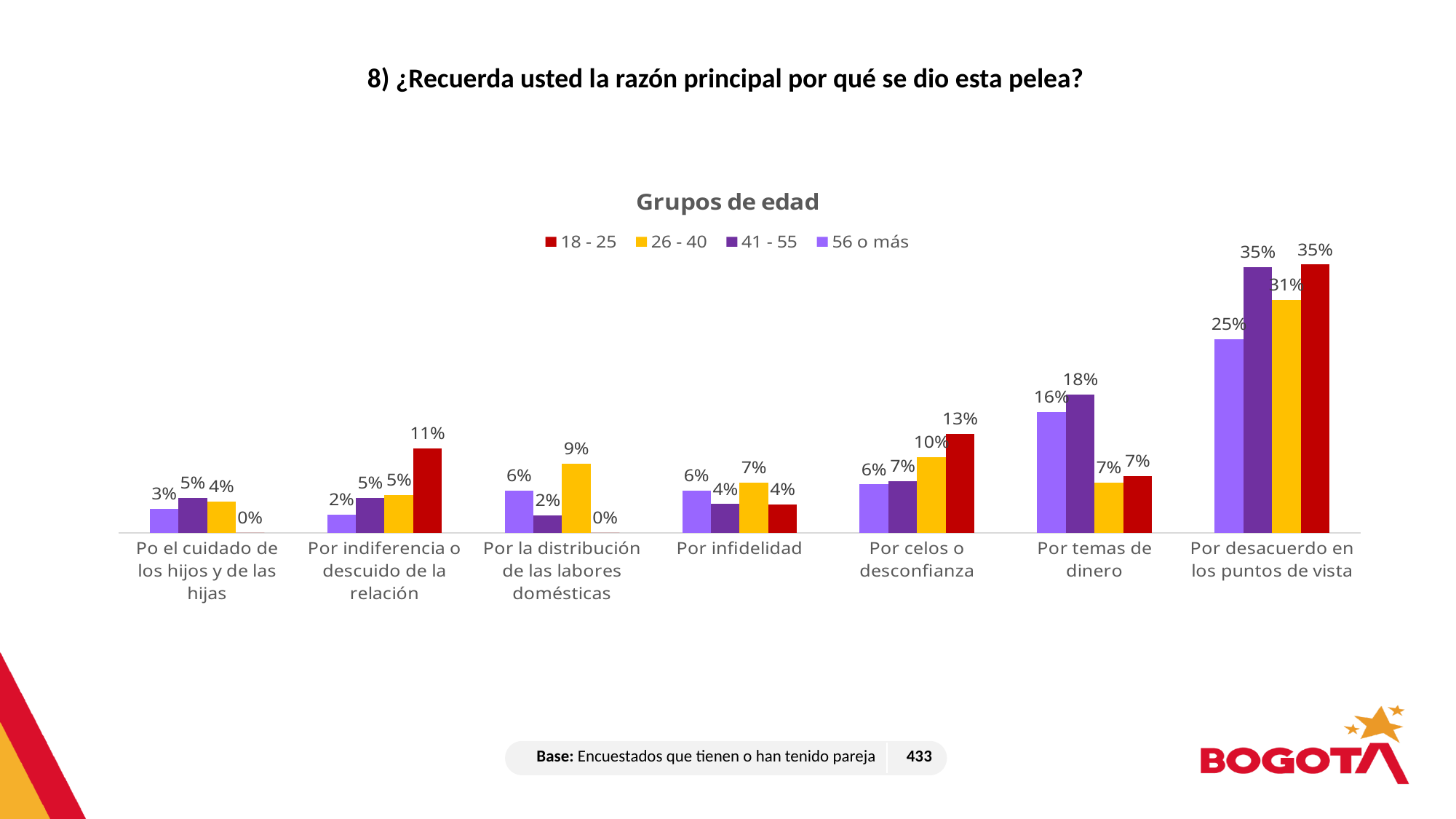
What is the title of the chart? Grupos de edad How many categories (reasons) are shown on the x axis? 7 For 'Por temas de dinero', which is larger: the 56 o más value or the 26 - 40 value? 56 o más What is the value for the 26 - 40 group for 'Por la distribución de las labores domésticas'? 9% What is the value for the 56 o más group for 'Por desacuerdo en los puntos de vista'? 25% What is the value for the 18 - 25 group for 'Por indiferencia o descuido de la relación'? 11% Which age group has the lowest value for 'Por desacuerdo en los puntos de vista'? 56 o más What is the difference between the 18 - 25 and 56 o más values for 'Por celos o desconfianza'? 7% How many series does the legend list? 4 Which category has the highest value for the 18 - 25 group? Por desacuerdo en los puntos de vista What type of chart is shown on the slide? bar chart What is the value for the 41 - 55 group for 'Por temas de dinero'? 18%